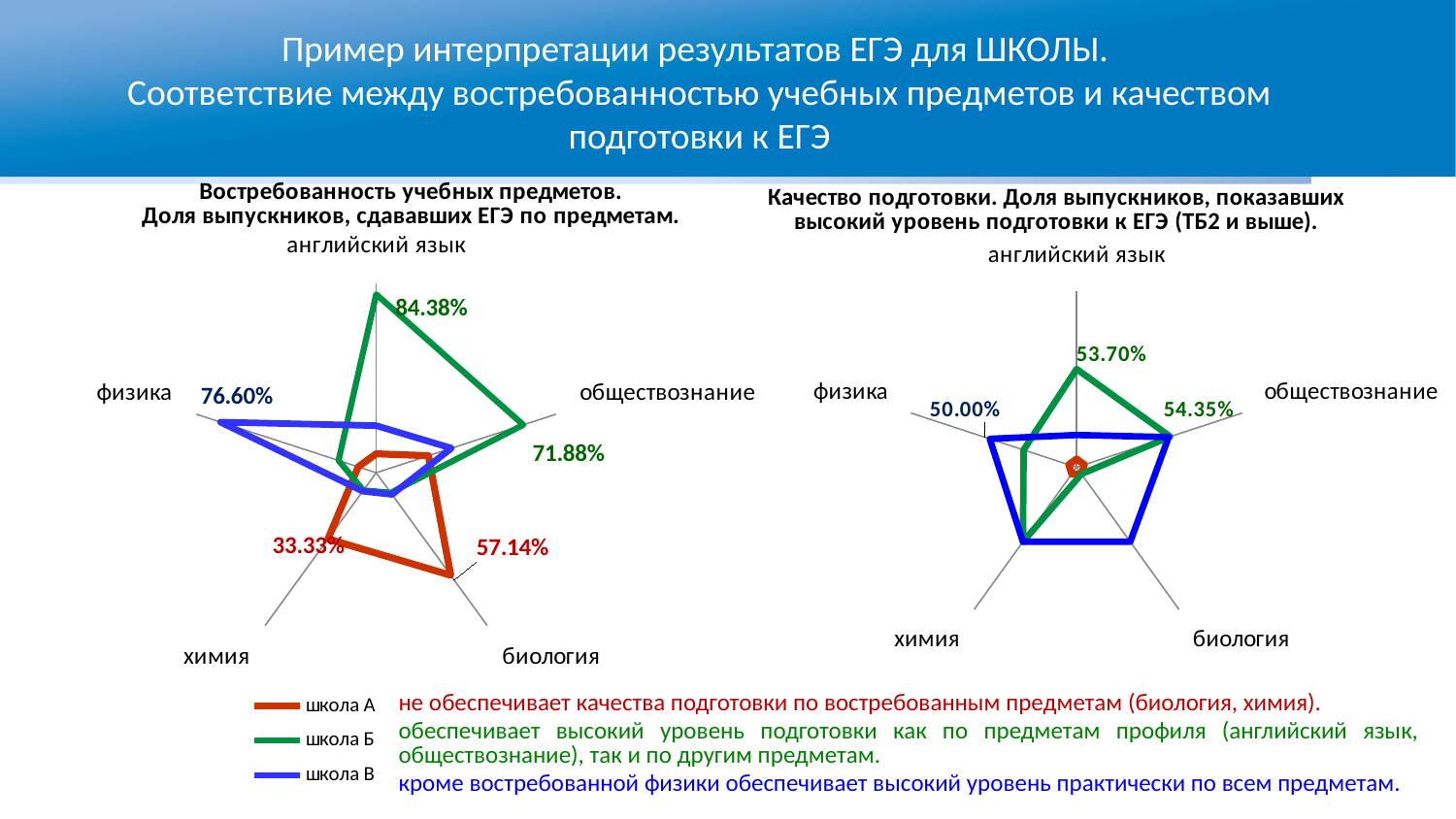
In the right chart (Качество подготовки), what is the value for школа Б on the обществознание axis? 54.35% How many subject axes does each radar chart have? 5 What type of chart is used on the left side of the slide (Востребованность учебных предметов)? Radar chart In the right chart (Качество подготовки), what is the value for школа Б on the английский язык axis? 53.70% In the left chart (Востребованность учебных предметов), what is the value for школа А on the химия axis? 33.33% How many series (schools) does the legend list? 3 In the left chart (Востребованность учебных предметов), what is the value for школа Б on the английский язык axis? 84.38% In the left chart (Востребованность учебных предметов), what is the value for школа Б on the обществознание axis? 71.88% In the right chart (Качество подготовки), what is the value for школа В on the физика axis? 50.00% In the left chart (Востребованность учебных предметов), what is the difference between школа Б's values for английский язык and обществознание? 12.50 percentage points In the left chart (Востребованность учебных предметов), what is the value for школа А on the биология axis? 57.14% In the left chart (Востребованность учебных предметов), what is the value for школа В on the физика axis? 76.60%